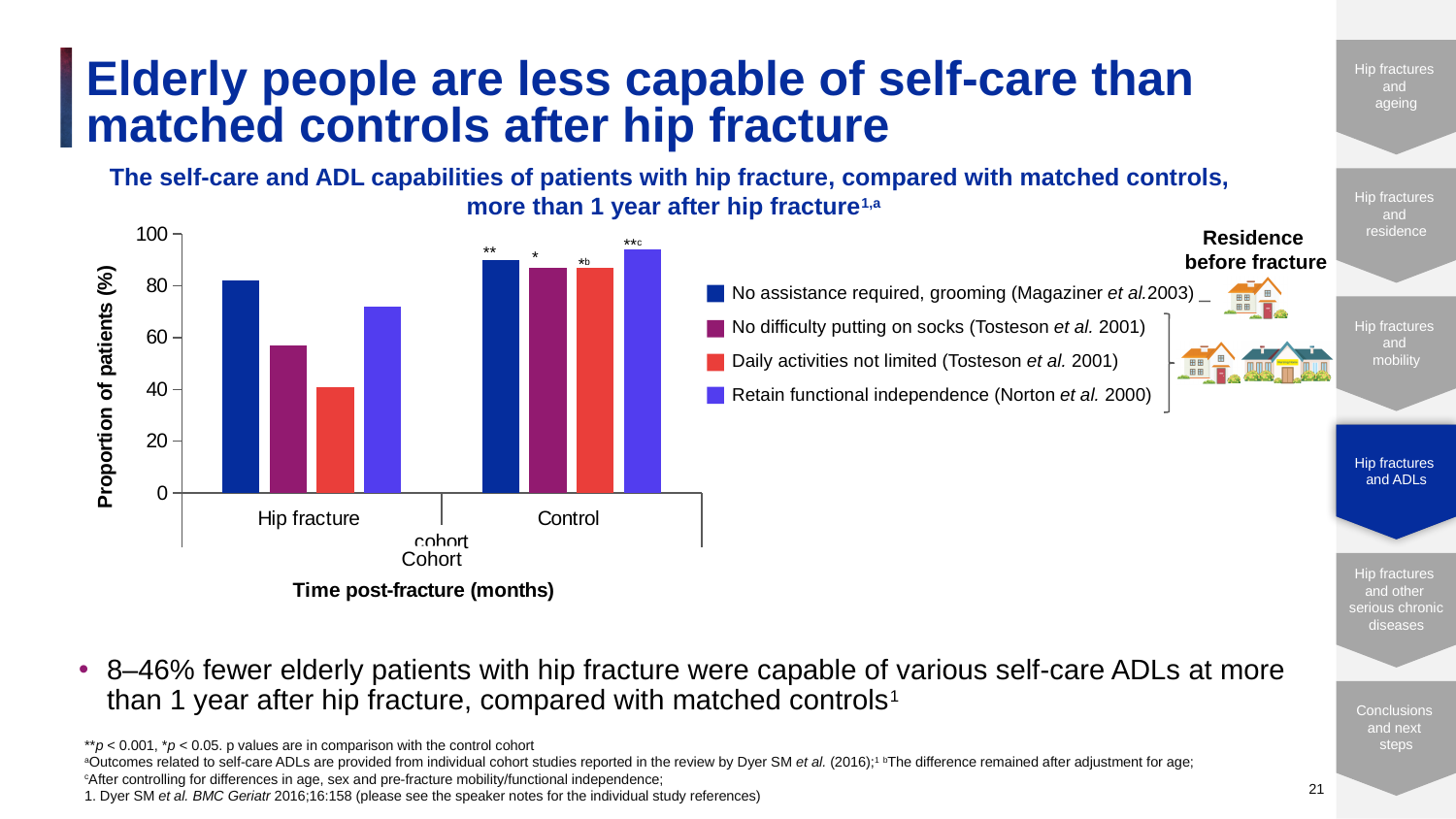
Is the value for 'No assistance required, grooming' in the Hip fracture cohort greater or less than 60? greater Within the Hip fracture cohort, which series has the highest proportion of patients? No assistance required, grooming (Magaziner et al. 2003) Which cohort has the larger value for 'Daily activities not limited', Hip fracture or Control? Control How many cohort categories are shown on the x axis of the chart? 2 What kind of chart is shown on the slide? Bar chart Is the value for 'Daily activities not limited' in the Hip fracture cohort greater or less than 60? less How many series does the chart's legend list? 4 Which colour represents 'Daily activities not limited (Tosteson et al. 2001)' in the chart legend? Red What is the label of the chart's y axis? Proportion of patients (%) Within the Hip fracture cohort, which series has the lowest proportion of patients? Daily activities not limited (Tosteson et al. 2001) Is the value for 'Retain functional independence' in the Control cohort greater or less than 80? greater